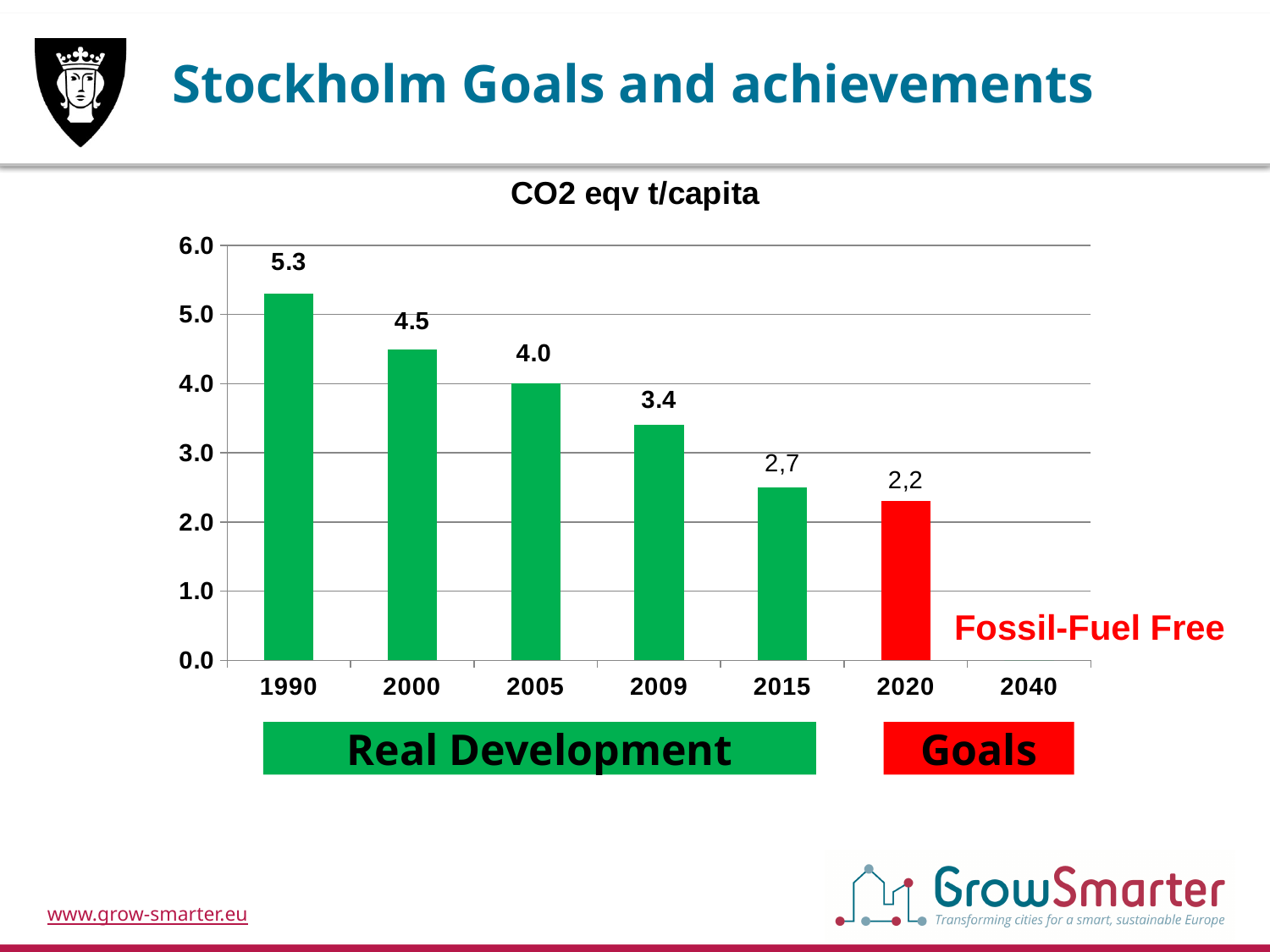
What is the CO2 eqv t/capita value for 1990? 5.3 What is the difference between the 1990 and 2000 values? 0.8 Is the value for 2015 greater or less than 3.0? less Which year has the highest CO2 eqv t/capita value? 1990 What value is labelled on the 2015 bar? 2,7 How many bars are plotted in the chart? 6 What is the CO2 eqv t/capita value for 2005? 4.0 Which is larger, the value for 2000 or the value for 2009? 2000 Do the values rise or fall from 1990 to 2020? fall Which year with a bar has the lowest labelled value? 2020 What value is labelled on the 2020 bar? 2,2 What kind of chart is shown on the slide? bar chart